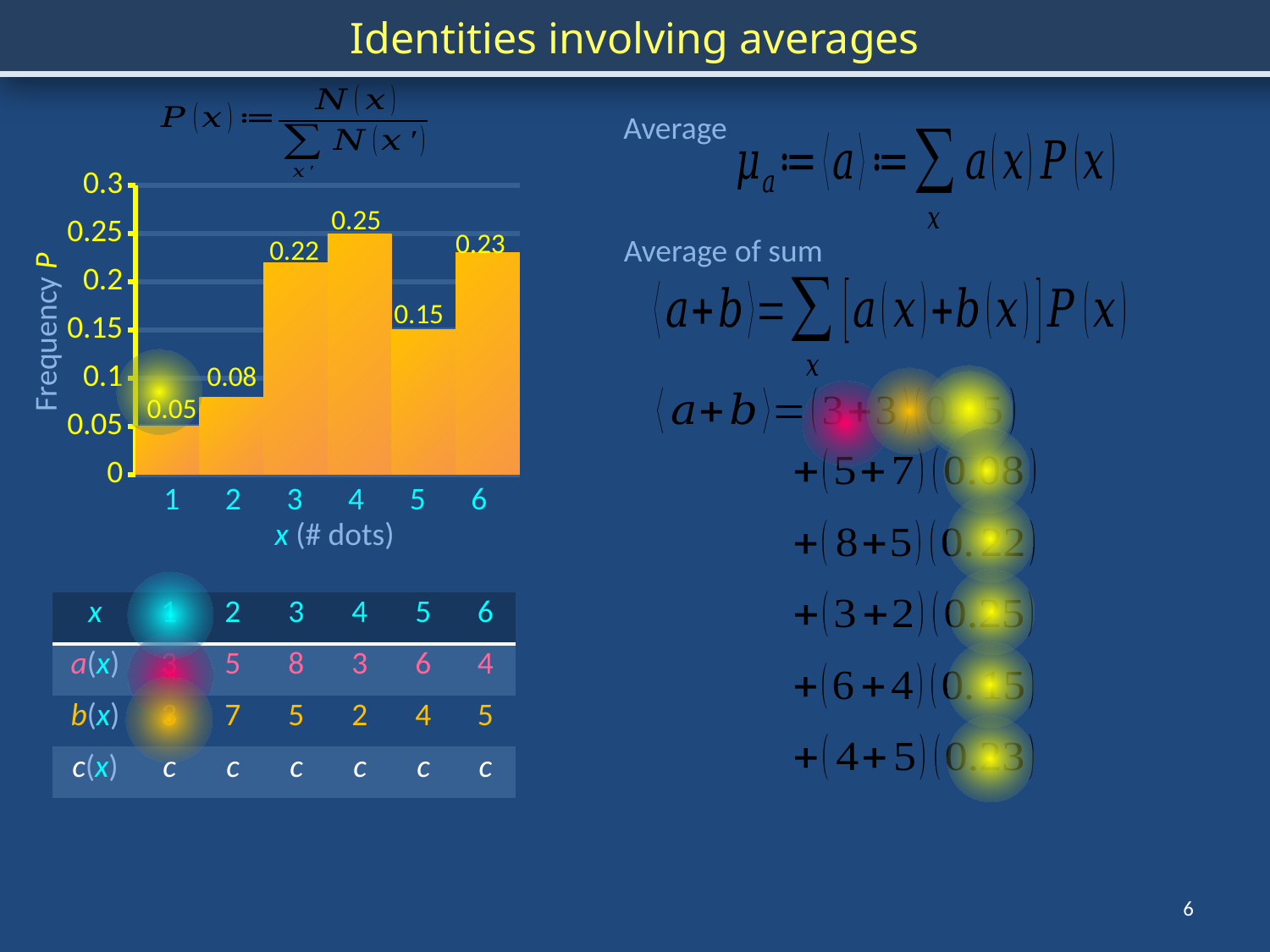
What kind of chart is shown on the slide? bar chart What is the frequency P for x = 5? 0.15 What is the frequency P for x = 3? 0.22 What is the frequency P for x = 1? 0.05 Is the frequency for x = 5 greater or less than 0.2? less Which has a higher frequency P, x = 3 or x = 6? x = 6 Which value of x has the lowest frequency P? 1 How many bars are plotted in the chart? 6 What is the difference between the frequency for x = 4 and the frequency for x = 2? 0.17 What is the label of the y axis of the chart? Frequency P What is the label of the x axis of the chart? x (# dots) Which value of x has the highest frequency P? 4